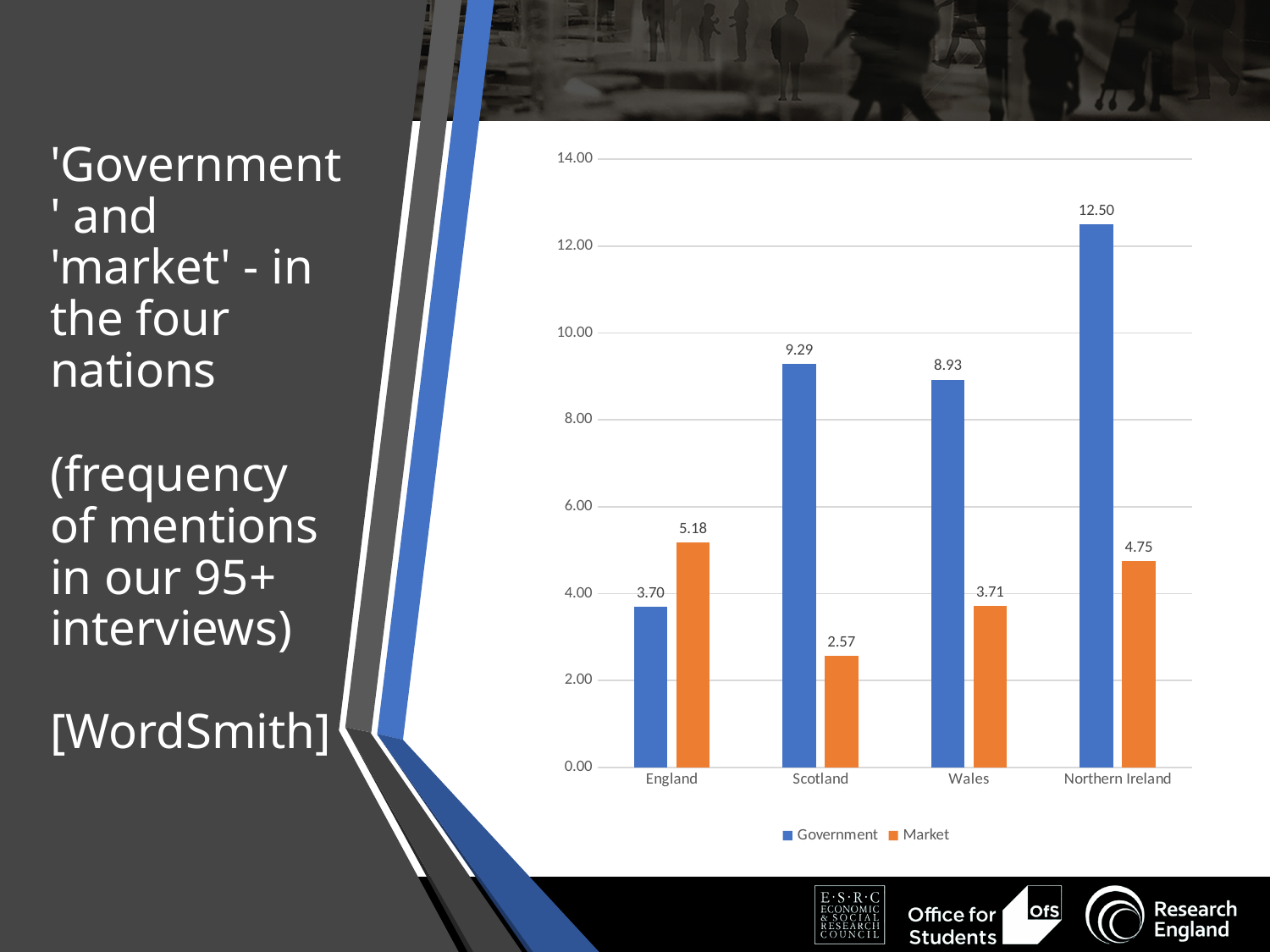
What is the Market value for England? 5.18 What is the Market value for Northern Ireland? 4.75 What is the difference between the Government and Market values for Wales? 5.22 For England, which is larger: the Government value or the Market value? Market What is the Government value for Scotland? 9.29 Is the Government value for Northern Ireland greater or less than 12.00? greater Which nation has the lowest Market value? Scotland Which nation has the highest Government value? Northern Ireland How many series does the legend list? 2 How many nations are shown on the x axis? 4 Which colour represents the Market series in the legend? Orange What kind of chart is shown on the slide? Bar chart